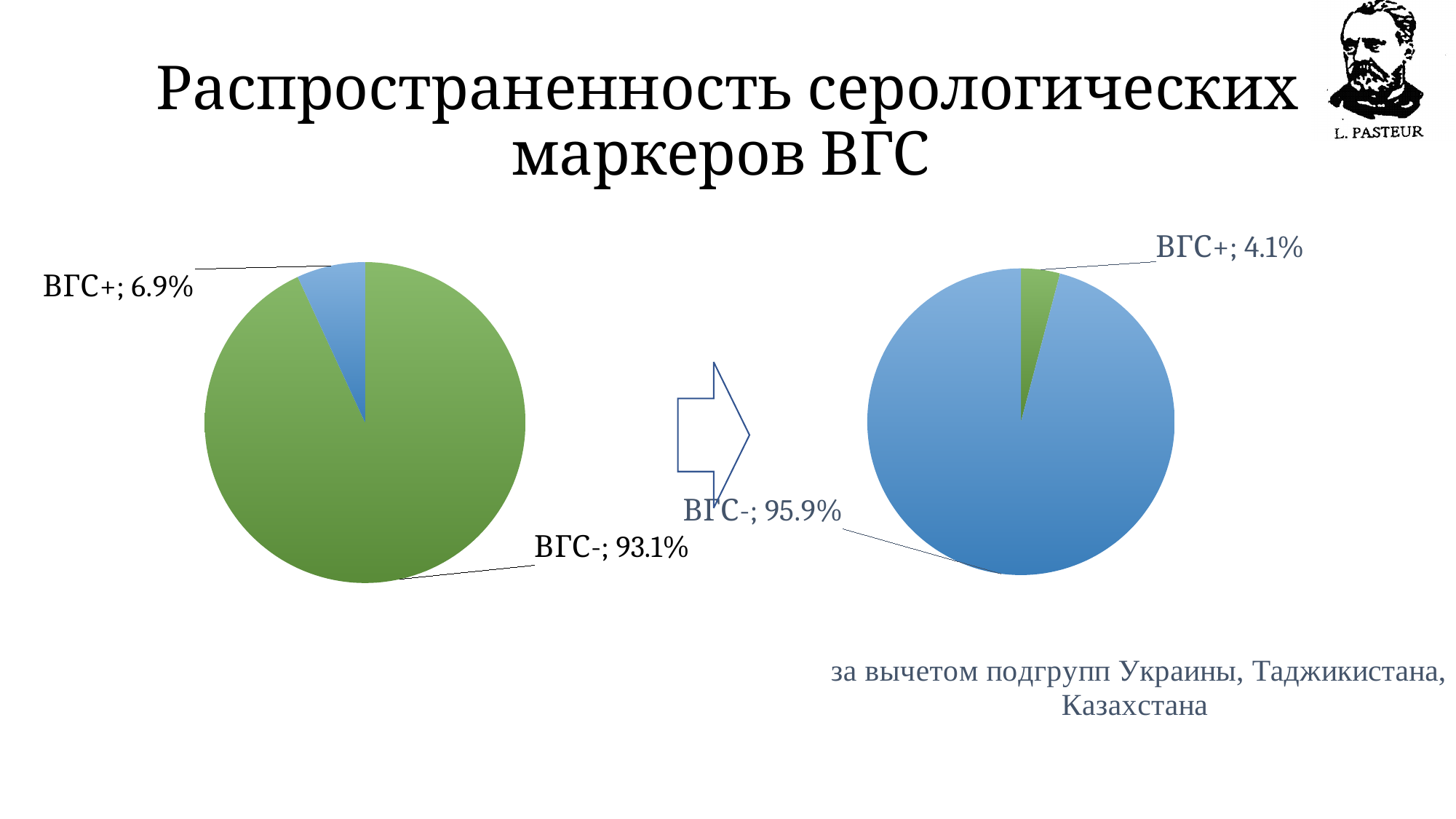
In the left pie chart, what is the value for ВГС-? 93.1% In the left pie chart, what colour is the ВГС- slice? Green In the left pie chart, what is the value for ВГС+? 6.9% In the right pie chart, what colour is the ВГС+ slice? Green In the right pie chart, what is the value for ВГС+? 4.1% In the right pie chart, which category has the smallest slice? ВГС+ Which is larger: ВГС+ in the left pie chart or ВГС+ in the right pie chart? ВГС+ in the left pie chart In the right pie chart, what is the value for ВГС-? 95.9% How many slices does the left pie chart have? 2 What is the difference between the ВГС+ value in the left pie chart and the ВГС+ value in the right pie chart? 2.8% What type of chart is shown on the left of the slide? Pie chart In the left pie chart, which category has the largest slice? ВГС-